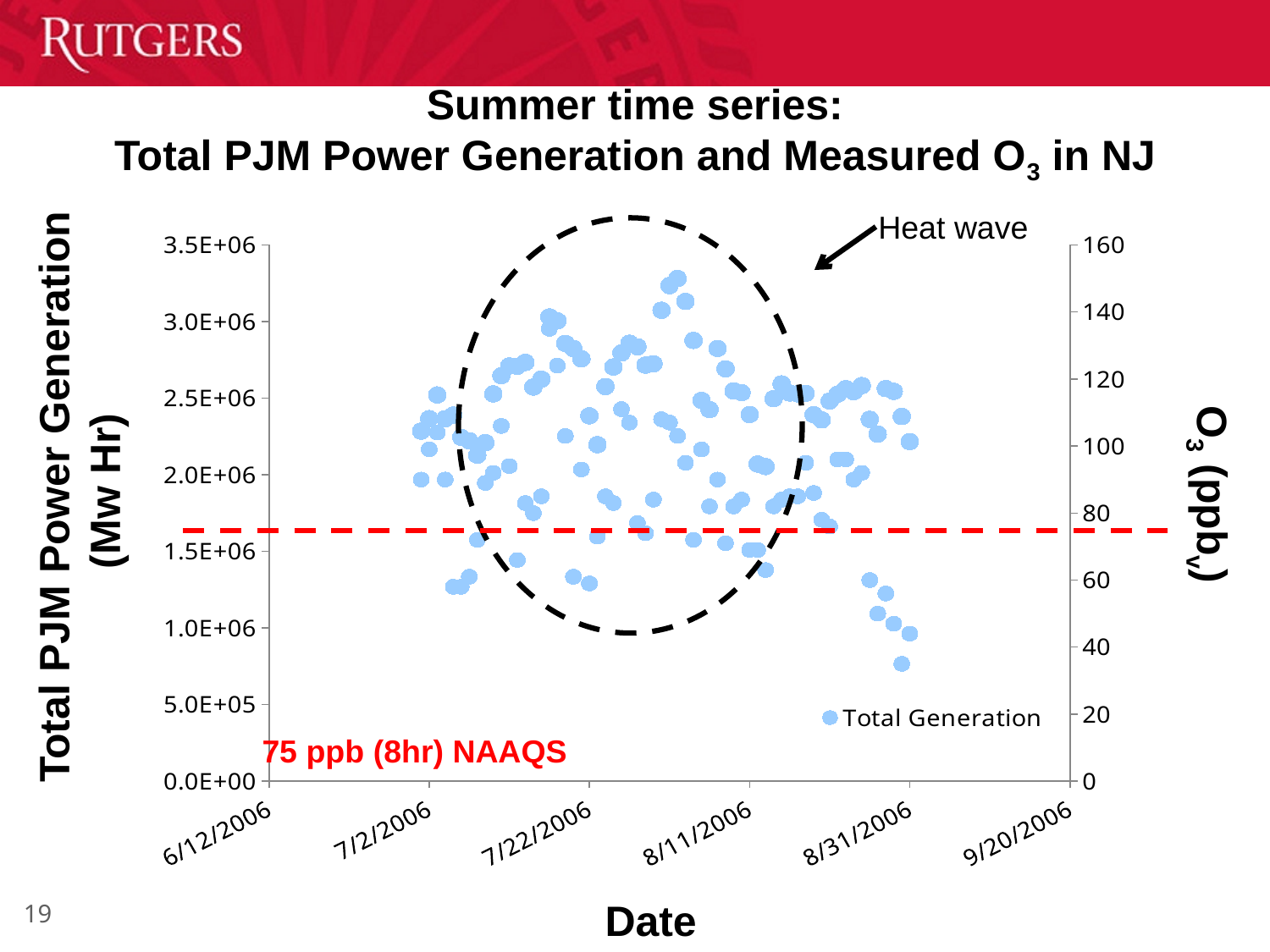
What is the first date label shown on the x axis? 6/12/2006 How many series does the chart legend list? 1 What is the maximum value shown on the right-hand O3 axis? 160 What kind of chart is shown on the slide? scatter chart What is the name of the series listed in the chart legend? Total Generation Is the highest plotted Total Generation value greater or less than 3.0E+06? greater How many date labels are shown along the x axis? 6 What value does the red dashed horizontal line represent? 75 ppb (8hr) NAAQS What label is attached to the dashed ellipse drawn around the cluster of points in the middle of the chart? Heat wave